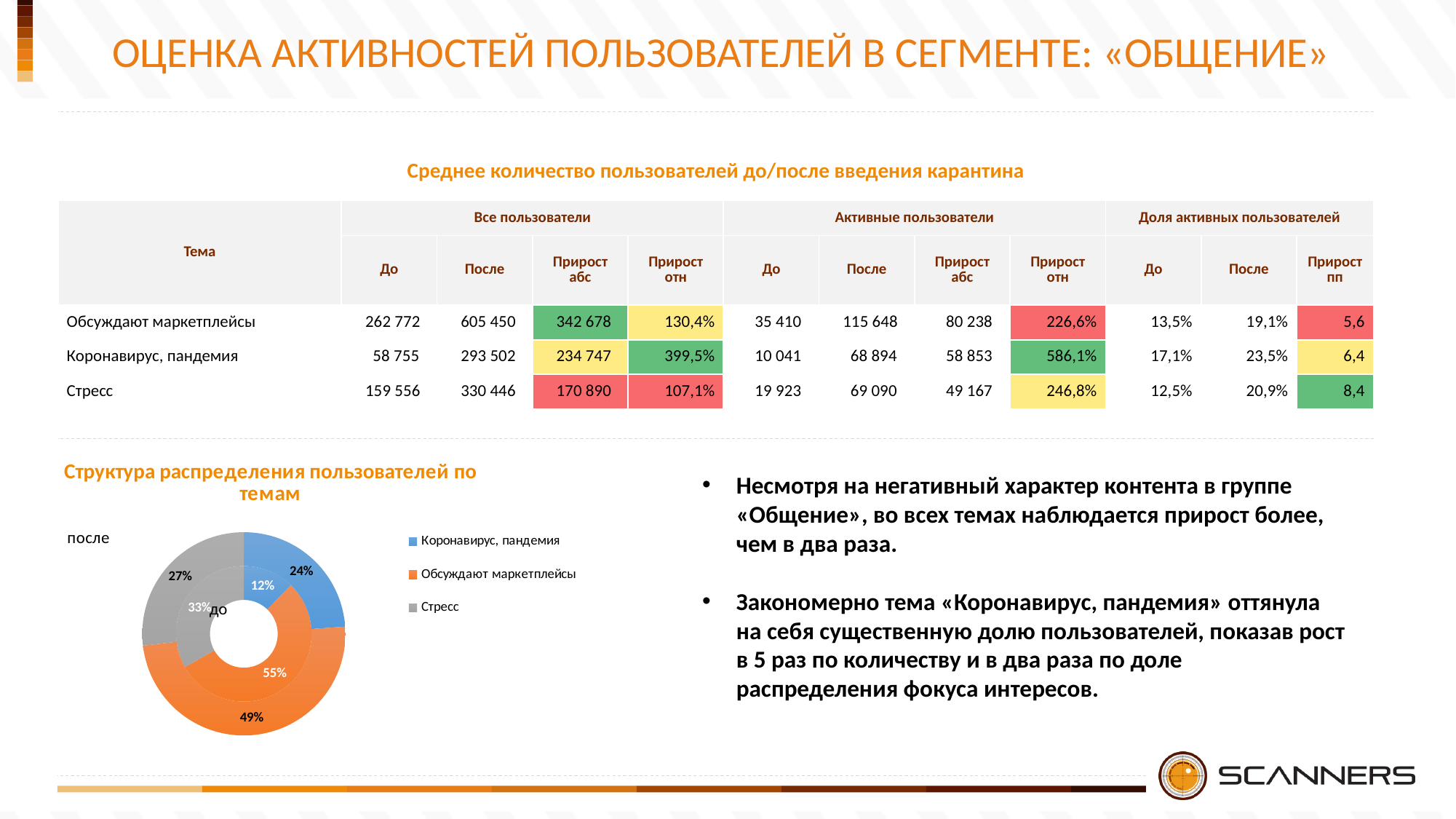
In the doughnut chart, what share does «Обсуждают маркетплейсы» have in the outer ring («после»)? 49% In the doughnut chart, what is the difference between the shares of «Обсуждают маркетплейсы» and «Стресс» in the outer ring («после»)? 22 percentage points In the doughnut chart, what share does «Коронавирус, пандемия» have in the inner ring («до»)? 12% In the doughnut chart, what colour represents «Стресс»? Grey In the doughnut chart, by how many percentage points did the share of «Коронавирус, пандемия» change from the inner ring («до», 12%) to the outer ring («после», 24%)? 12 percentage points What kind of chart is shown under the title «Структура распределения пользователей по темам»? Doughnut chart In the doughnut chart, which is larger: the share of «Стресс» in the inner ring («до») or in the outer ring («после»)? Inner ring («до») In the doughnut chart, which topic has the largest share in the outer ring («после»)? Обсуждают маркетплейсы In the doughnut chart, what share does «Коронавирус, пандемия» have in the outer ring («после»)? 24% In the doughnut chart, which topic has the smallest share in the inner ring («до»)? Коронавирус, пандемия In the doughnut chart, what share does «Стресс» have in the inner ring («до»)? 33% How many series does the legend of the doughnut chart list? 3